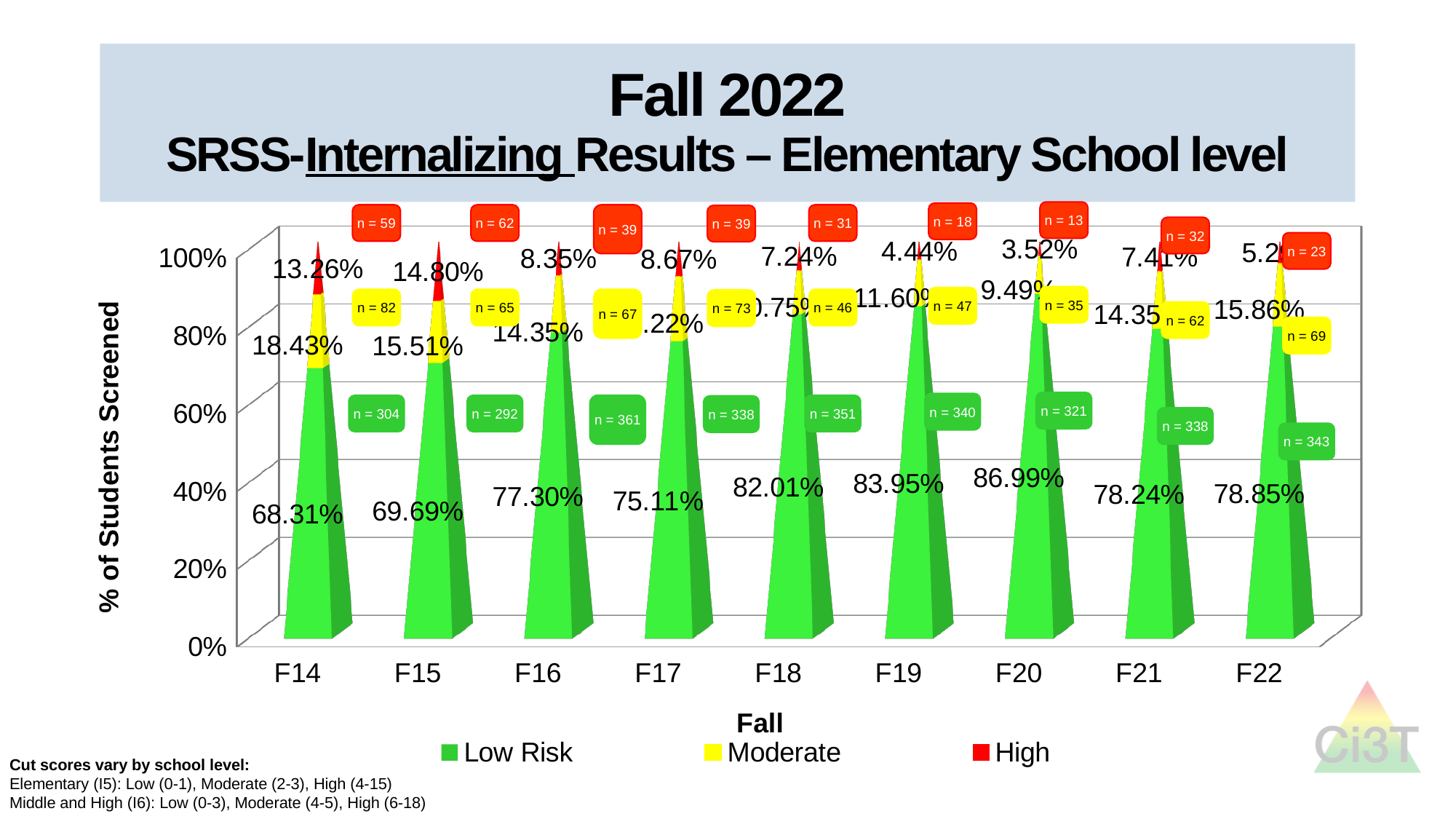
Which Fall has the lowest High percentage? F20 Which Fall has the highest High percentage? F15 What is the Low Risk percentage for F20? 86.99% What kind of chart is shown on the slide? Stacked bar chart How many Fall categories are shown on the x axis? 9 How many series does the legend list? 3 What is the n value shown for the Low Risk group in F16? n = 361 Which has the larger Moderate percentage, F14 or F15? F14 What is the difference in Low Risk percentage between F20 and F14? 18.68 percentage points What is the High percentage for F14? 13.26% Which Fall has the highest Low Risk percentage? F20 Which Fall has the lowest Low Risk percentage? F14